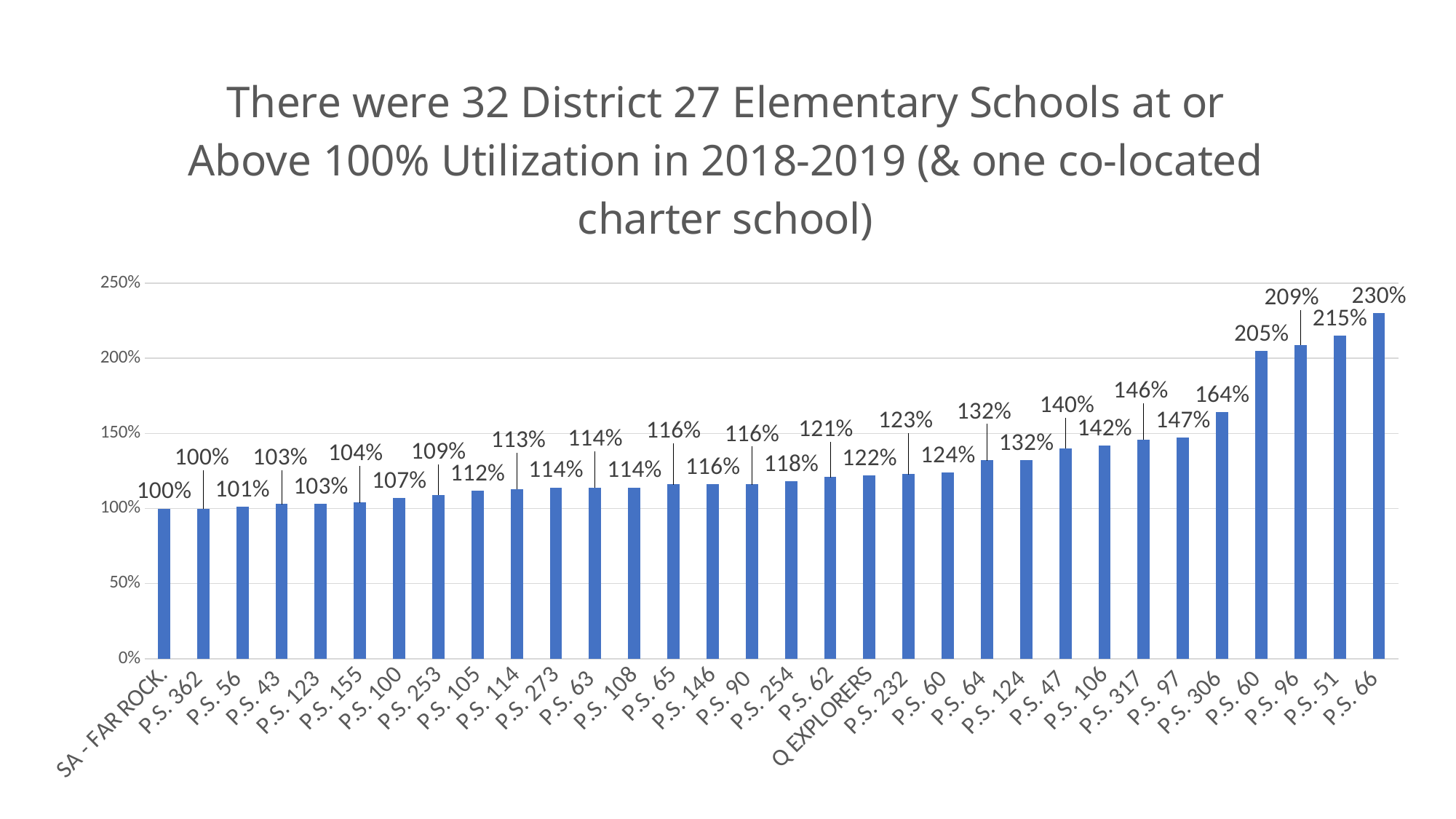
What is the utilization value shown for P.S. 51? 215% What is the utilization value shown for P.S. 306? 164% What is the lowest utilization value shown in the chart? 100% Which has a higher utilization, P.S. 97 or P.S. 47? P.S. 97 How many schools (bars) are shown in the chart? 32 What is the utilization value shown for Q EXPLORERS? 122% What is the utilization value shown for P.S. 253? 109% What is the difference between the utilization of P.S. 66 and P.S. 51? 15% Is the value for P.S. 306 greater or less than 150%? greater Do the values generally rise or fall from left to right along the x axis? rise What is the utilization value shown for P.S. 66? 230% Which school has the highest utilization in the chart? P.S. 66